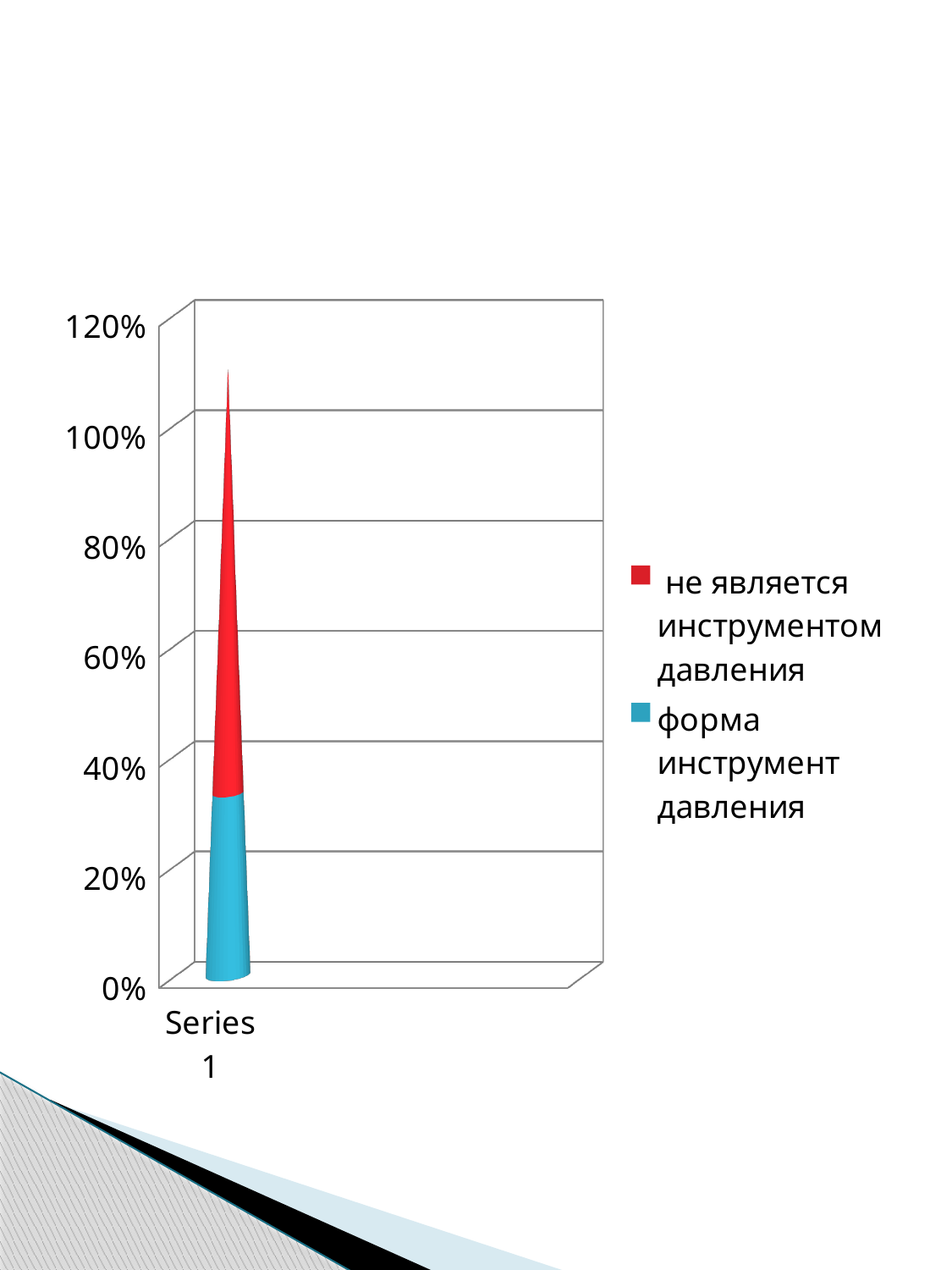
Which series has the larger value in Series 1: "не является инструментом давления" or "форма инструмент давления"? не является инструментом давления What is the label of the single category on the x axis? Series 1 Is the value for "форма инструмент давления" greater or less than 20%? greater Is the value for "форма инструмент давления" greater or less than 40%? less How many categories are shown on the x axis? 1 Which colour represents the series "форма инструмент давления"? blue What kind of chart is shown on the slide? bar chart How many series does the legend list? 2 What is the highest value shown on the vertical axis? 120%